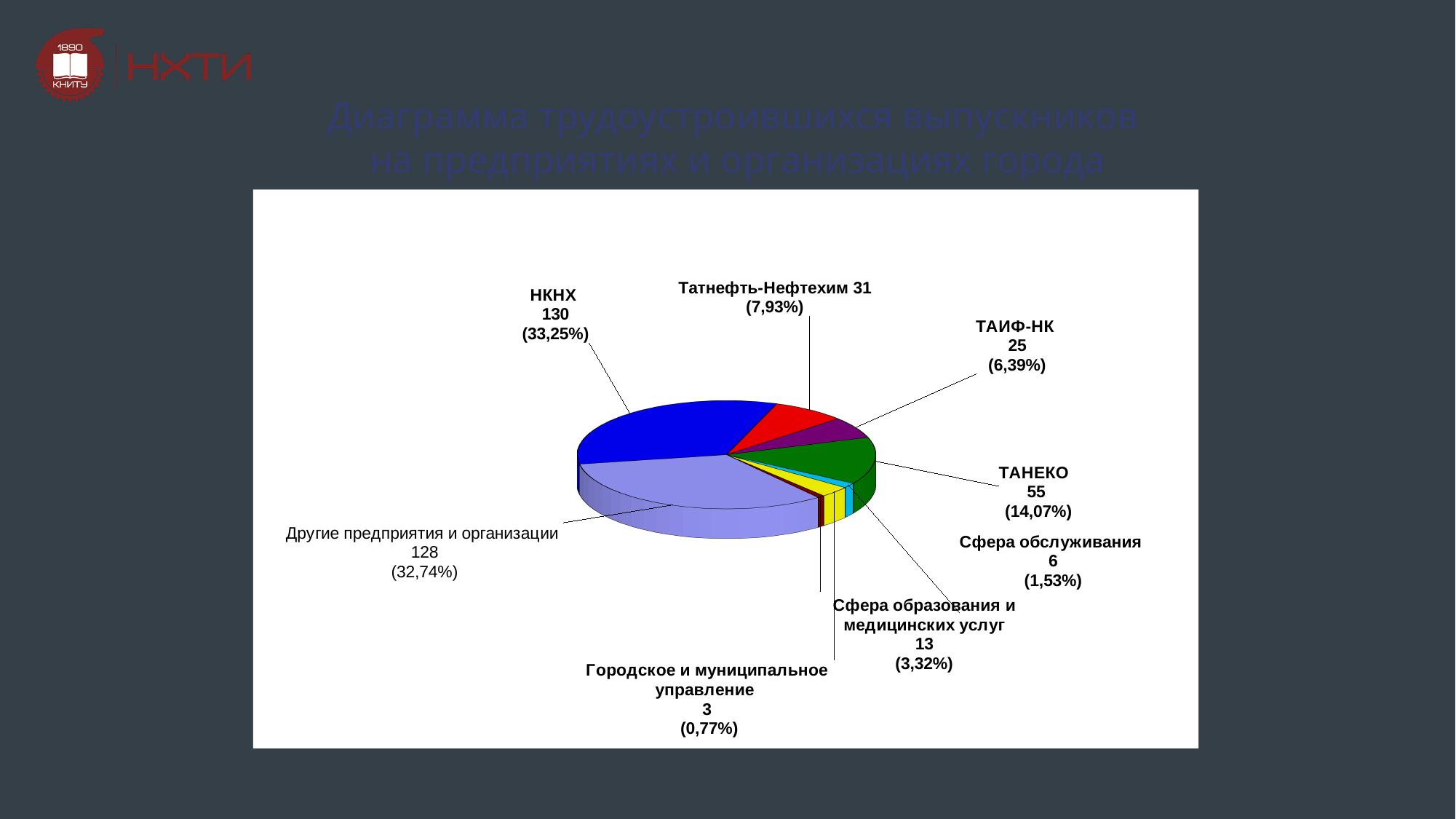
What is the value shown for Татнефть-Нефтехим? 31 What is the difference between the values for НКНХ and Другие предприятия и организации? 2 What kind of chart is shown on the slide? Pie chart What percentage share is shown for Сфера обслуживания? 1,53% How many slices does the pie chart have? 8 What colour is the slice for НКНХ? Blue Which category has the largest slice of the pie? НКНХ What is the difference between the values for ТАНЕКО and ТАИФ-НК? 30 Which category has the smallest slice of the pie? Городское и муниципальное управление How many graduates were employed at НКНХ according to the pie chart? 130 What share of the pie does ТАНЕКО represent? 14,07% Which is larger, the value for ТАИФ-НК or the value for Сфера образования и медицинских услуг? ТАИФ-НК